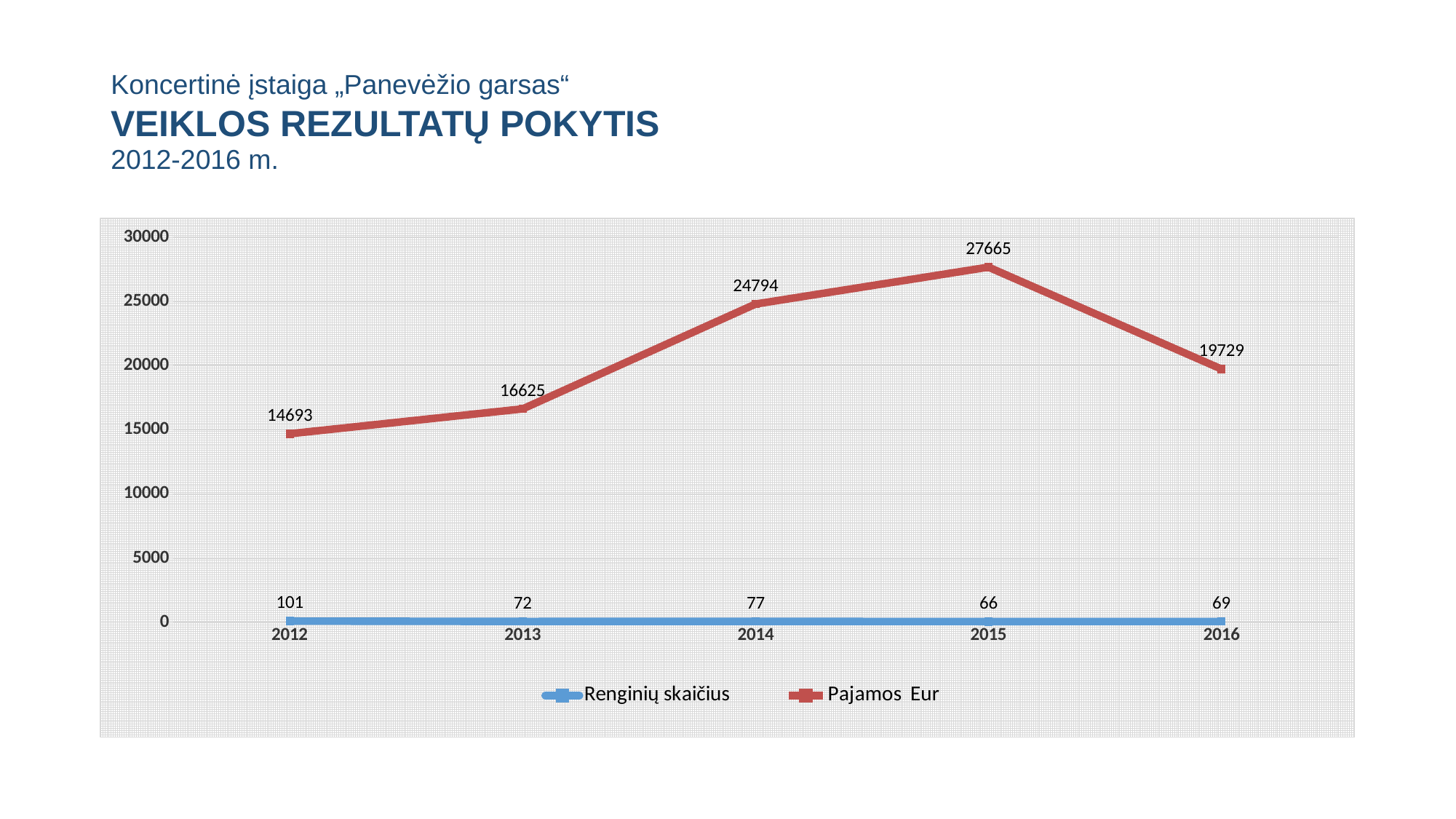
Does Pajamos Eur rise or fall from 2012 to 2015? rise What kind of chart is shown on the slide? line chart What is the difference between Pajamos Eur in 2015 and in 2016? 7936 Is the value of Pajamos Eur in 2014 greater or less than 20000? greater In which year is Renginių skaičius lowest? 2015 What is the value of Pajamos Eur in 2015? 27665 In which year is Pajamos Eur highest? 2015 Which is larger, Renginių skaičius in 2013 or in 2014? 2014 What is the value of Renginių skaičius in 2012? 101 How many series does the legend list? 2 What is the value of Pajamos Eur in 2013? 16625 How many years are shown on the x axis? 5